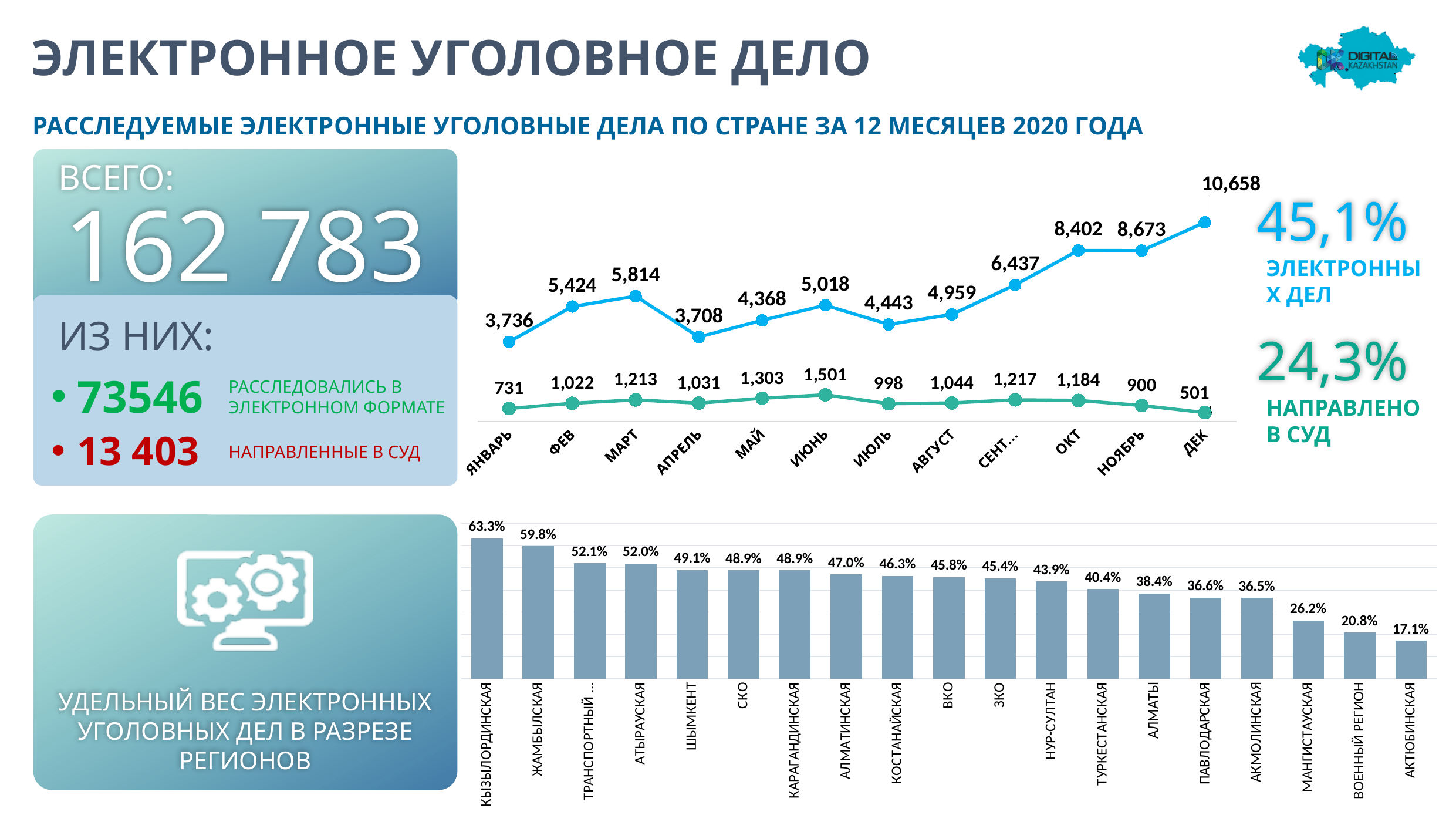
In the line chart at the top of the slide, which month has the lowest value on the blue line? АПРЕЛЬ In the line chart at the top of the slide, what is the difference between the blue line values for НОЯБРЬ and ОКТ? 271 In the bar chart at the bottom of the slide, which region has the lowest value? АКТЮБИНСКАЯ What type of chart is shown at the bottom of the slide? bar chart In the line chart at the top of the slide, does the blue line rise or fall between СЕНТ... and ДЕК? rise In the line chart at the top of the slide, how many months are plotted along the x axis? 12 In the bar chart at the bottom of the slide, how many regions are shown? 19 In the bar chart at the bottom of the slide, what is the value for ШЫМКЕНТ? 49.1% In the line chart at the top of the slide, which month has the lowest value on the green line? ДЕК In the line chart at the top of the slide, what is the value of the green line for ИЮНЬ? 1,501 In the bar chart at the bottom of the slide, which region has the highest value? КЫЗЫЛОРДИНСКАЯ In the line chart at the top of the slide, what is the value of the blue line for ДЕК? 10,658